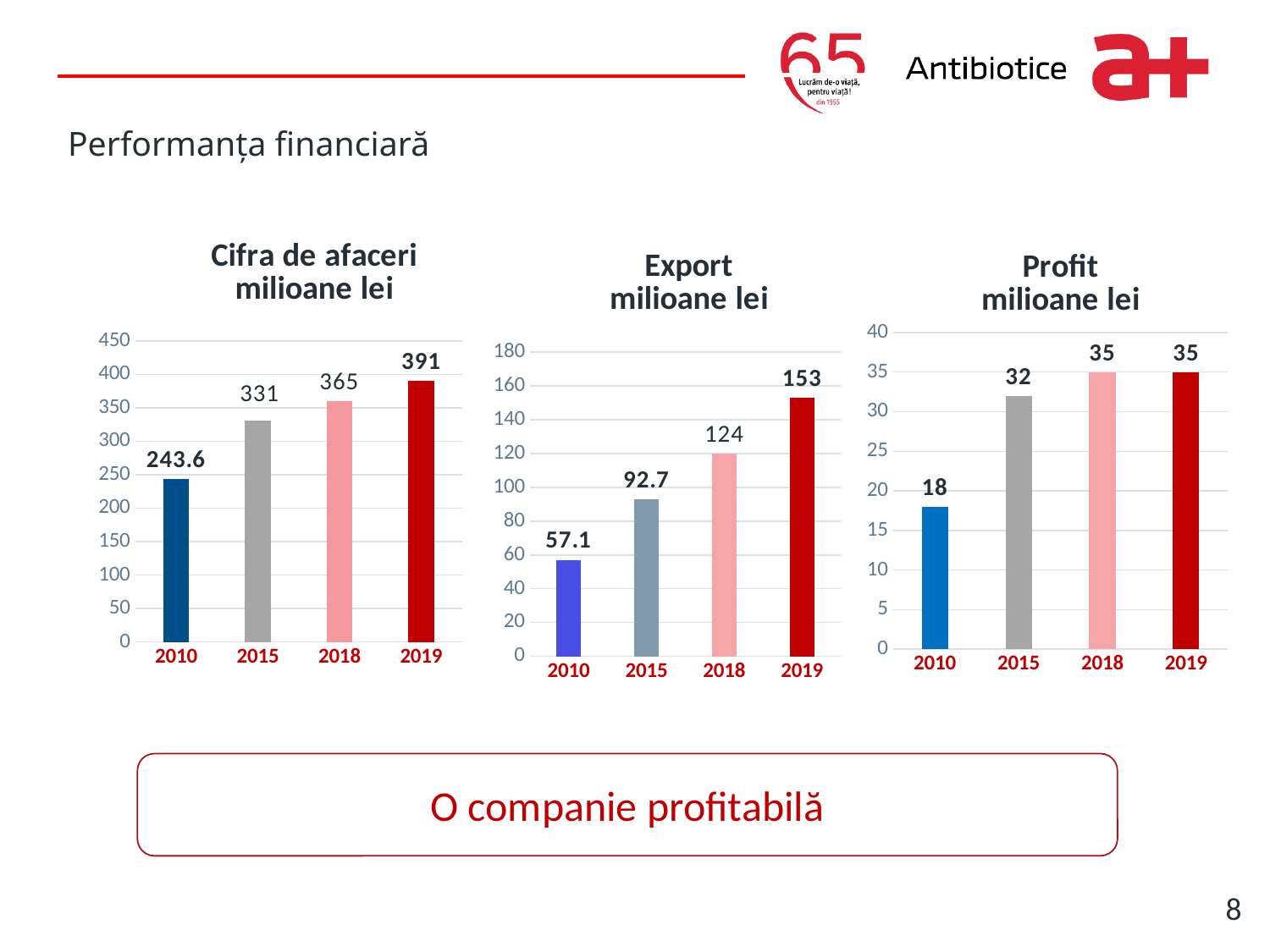
In the 'Cifra de afaceri milioane lei' chart, which is larger, the value for 2015 or the value for 2018? 2018 In the 'Cifra de afaceri milioane lei' chart, what is the value for 2019? 391 In the 'Export milioane lei' chart, what is the value for 2015? 92.7 In the 'Profit milioane lei' chart, what is the difference between the 2018 and 2010 values? 17 In the 'Cifra de afaceri milioane lei' chart, do the values rise or fall from 2010 to 2019? rise In the 'Profit milioane lei' chart, what is the value for 2015? 32 How many charts are shown on the slide? 3 What kind of chart is the 'Export milioane lei' chart? bar chart How many bars are in the 'Profit milioane lei' chart? 4 In the 'Cifra de afaceri milioane lei' chart, what is the value for 2010? 243.6 In the 'Export milioane lei' chart, what is the difference between the 2019 and 2018 values? 29 In the 'Export milioane lei' chart, which year has the lowest value? 2010